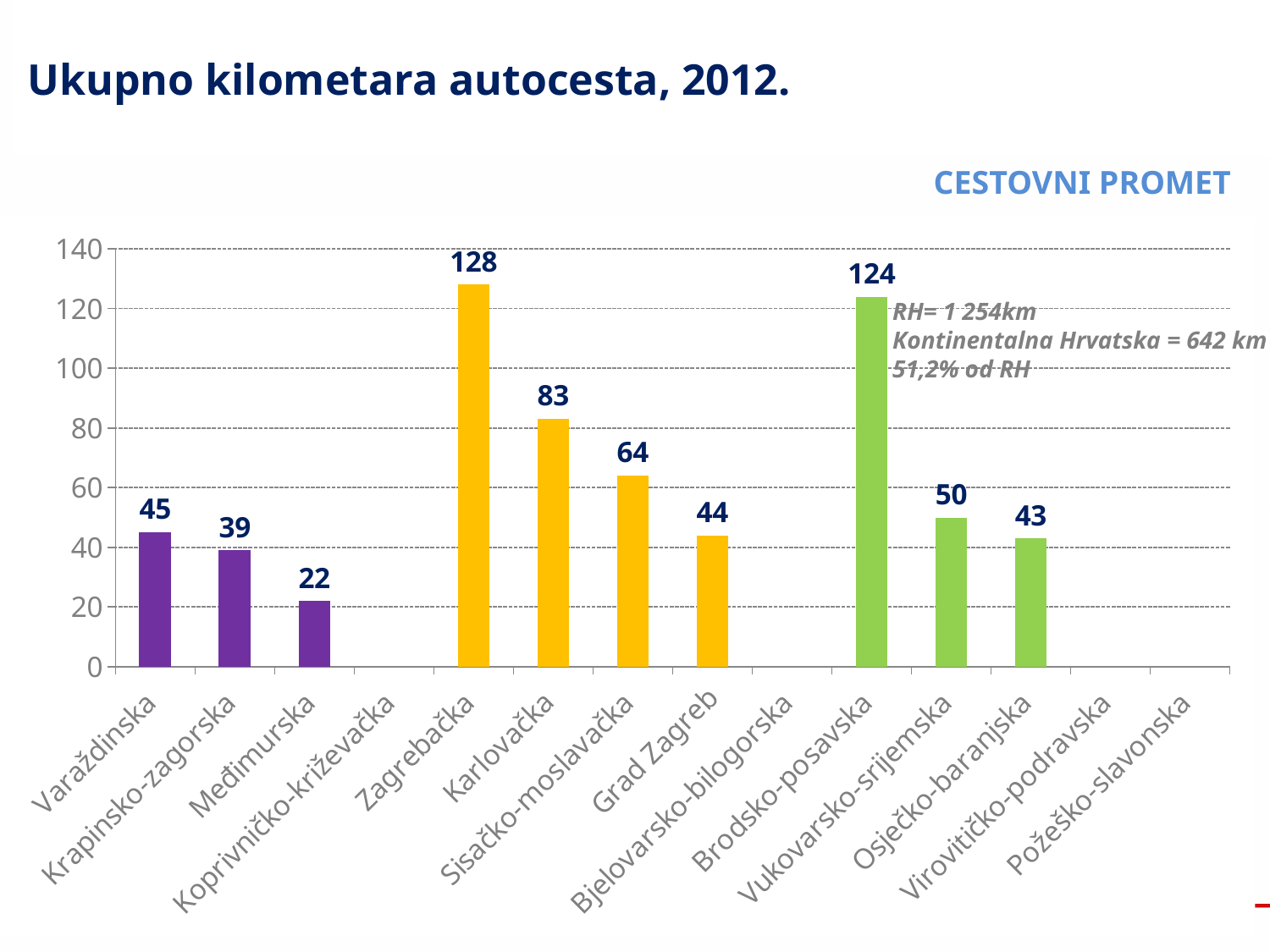
What is the value for Vukovarsko-srijemska? 50 What is the difference between the values for Karlovačka and Sisačko-moslavačka? 19 Is the value for Karlovačka greater or less than 100? less What kind of chart is shown on the slide? bar chart What is the value for Zagrebačka? 128 What is the difference between the values for Zagrebačka and Brodsko-posavska? 4 Which category has the highest value? Zagrebačka What is the title of the chart? Ukupno kilometara autocesta, 2012. What is the value for Međimurska? 22 How many category labels are shown on the x axis? 14 Which category with a plotted bar has the lowest value? Međimurska Which is larger, the value for Varaždinska or the value for Grad Zagreb? Varaždinska